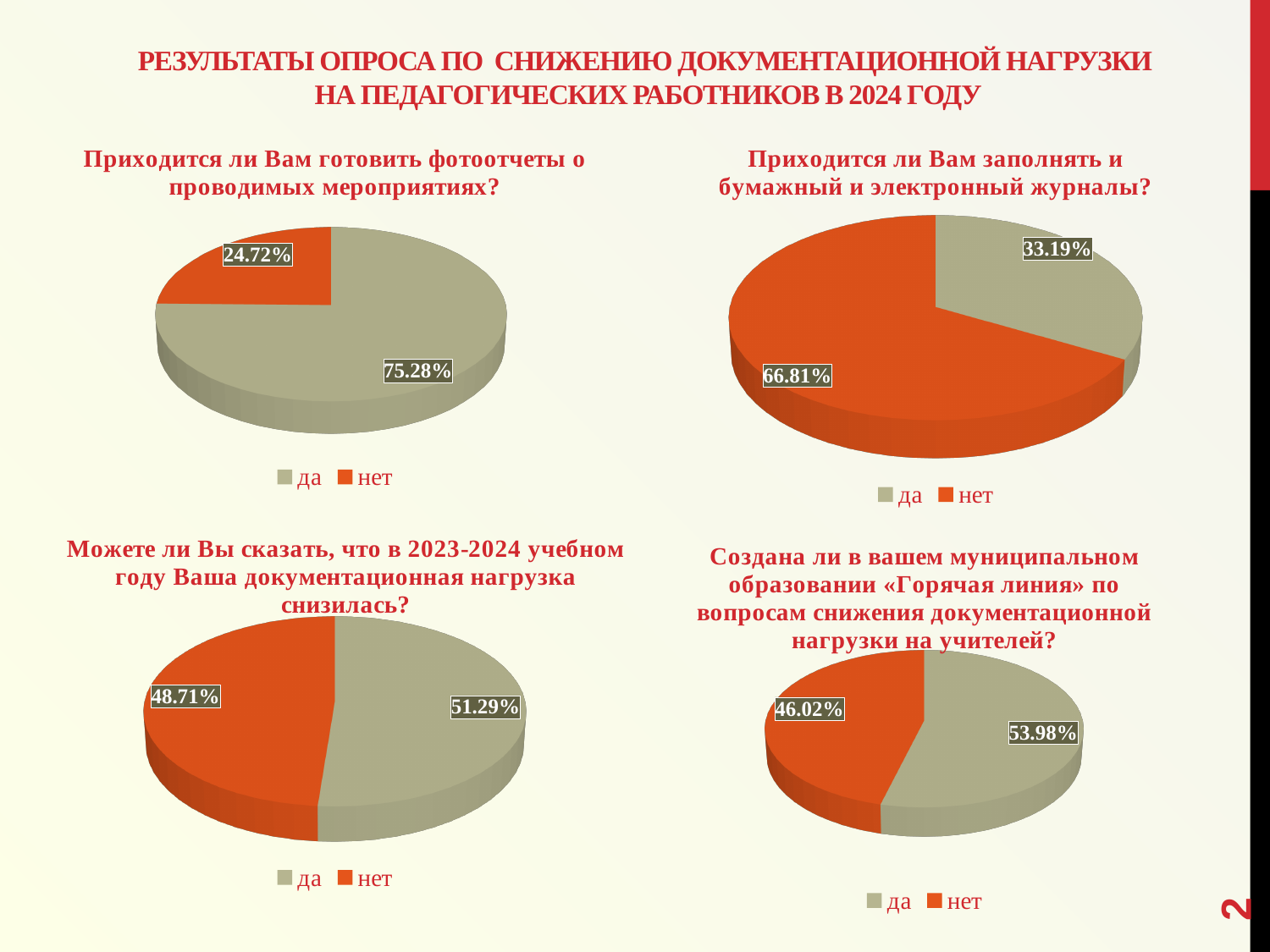
How many entries does the legend of the bottom-left pie chart list? 2 In the top-right pie chart (about filling in both paper and electronic journals), which answer has the smaller share? да In the bottom-right pie chart (about the "Горячая линия" hotline), what share of respondents answered "нет"? 46.02% In the top-right pie chart (about filling in both paper and electronic journals), what share of respondents answered "нет"? 66.81% In the top-right pie chart (about filling in both paper and electronic journals), what share of respondents answered "да"? 33.19% In the top-left pie chart (about preparing photo reports), which answer has the larger share? да In the top-left pie chart (about preparing photo reports), what is the difference in percentage points between the "да" and "нет" shares? 50.56 In the top-left pie chart (about preparing photo reports), what share of respondents answered "нет"? 24.72% In the bottom-left pie chart (about whether documentation load decreased in 2023-2024), what share of respondents answered "да"? 51.29% What type of chart is used for the four charts on the slide? Pie chart In the bottom-right pie chart (about the "Горячая линия" hotline), which is larger: the share for "да" or the share for "нет"? да In the top-left pie chart (about preparing photo reports), what share of respondents answered "да"? 75.28%